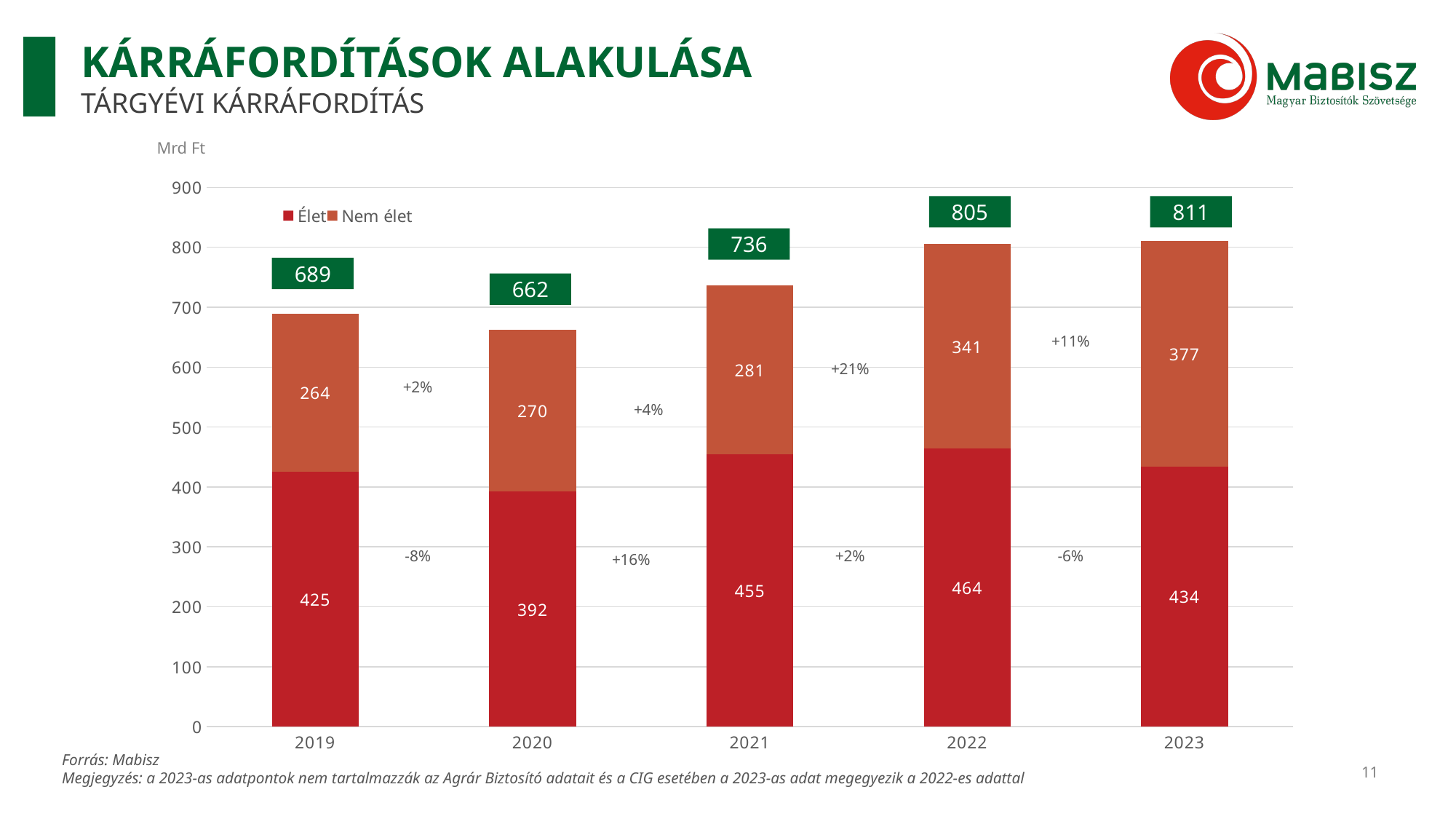
Which year has the highest total? 2023 Which year has the lowest Élet value? 2020 What is the value of the Nem élet series for 2023? 377 Do the total values rise or fall from 2020 to 2023? rise How many series does the legend list? 2 What is the difference between the Nem élet values for 2022 and 2019? 77 What is the value of the Élet series for 2021? 455 Which is larger, the Élet value for 2022 or the Élet value for 2023? 2022 What unit is shown above the y axis? Mrd Ft How many years are shown on the x axis? 5 What kind of chart is shown on the slide? stacked bar chart What is the total of the stacked bar for 2020? 662